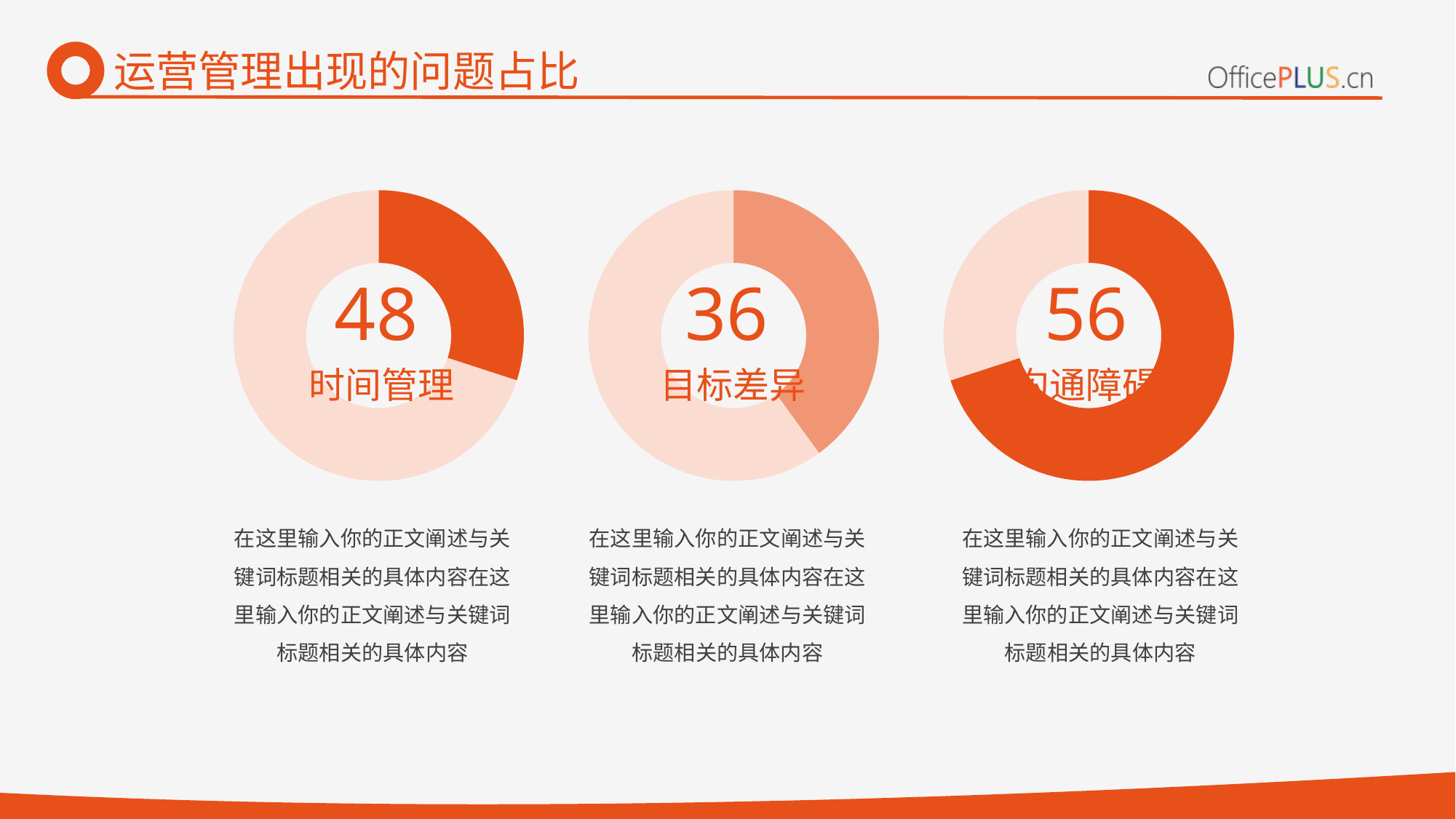
Which of the three donut charts shows the highest value? 沟通障碍 (56) What value is shown in the centre of the right donut chart labelled 沟通障碍? 56 Which is larger, the value for 时间管理 or the value for 目标差异? 时间管理 What is the title of the slide? 运营管理出现的问题占比 Which of the three donut charts shows the lowest value? 目标差异 (36) Is the value for 沟通障碍 greater or less than 50? greater How many donut charts are shown on the slide? 3 What kind of chart is used to show each value on the slide? Donut chart What value is shown in the centre of the left donut chart labelled 时间管理? 48 What is the difference between the value for 沟通障碍 and the value for 时间管理? 8 What is the difference between the value for 时间管理 and the value for 目标差异? 12 What value is shown in the centre of the middle donut chart labelled 目标差异? 36